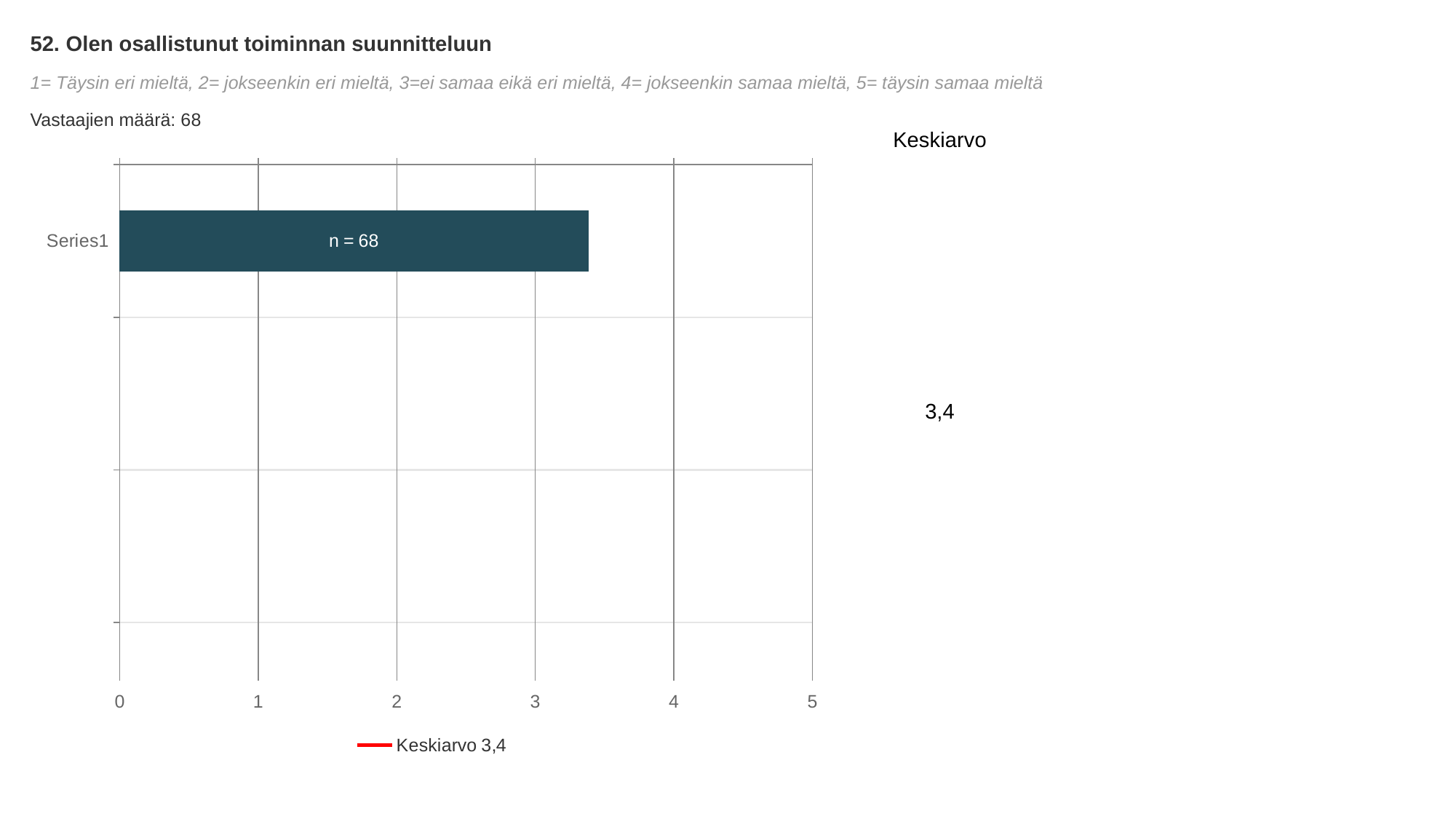
What is the Keskiarvo (mean) value shown on the slide? 3,4 Is the value of the Series1 bar greater or less than 4? less What is the highest value shown on the x axis? 5 Is the value of the Series1 bar greater or less than 3? greater How many bars are plotted in the chart? 1 What does the legend entry below the chart say? Keskiarvo 3,4 What is the number of respondents (Vastaajien määrä) stated on the slide? 68 What data label is printed on the Series1 bar? n = 68 What kind of chart is shown on the slide? bar chart